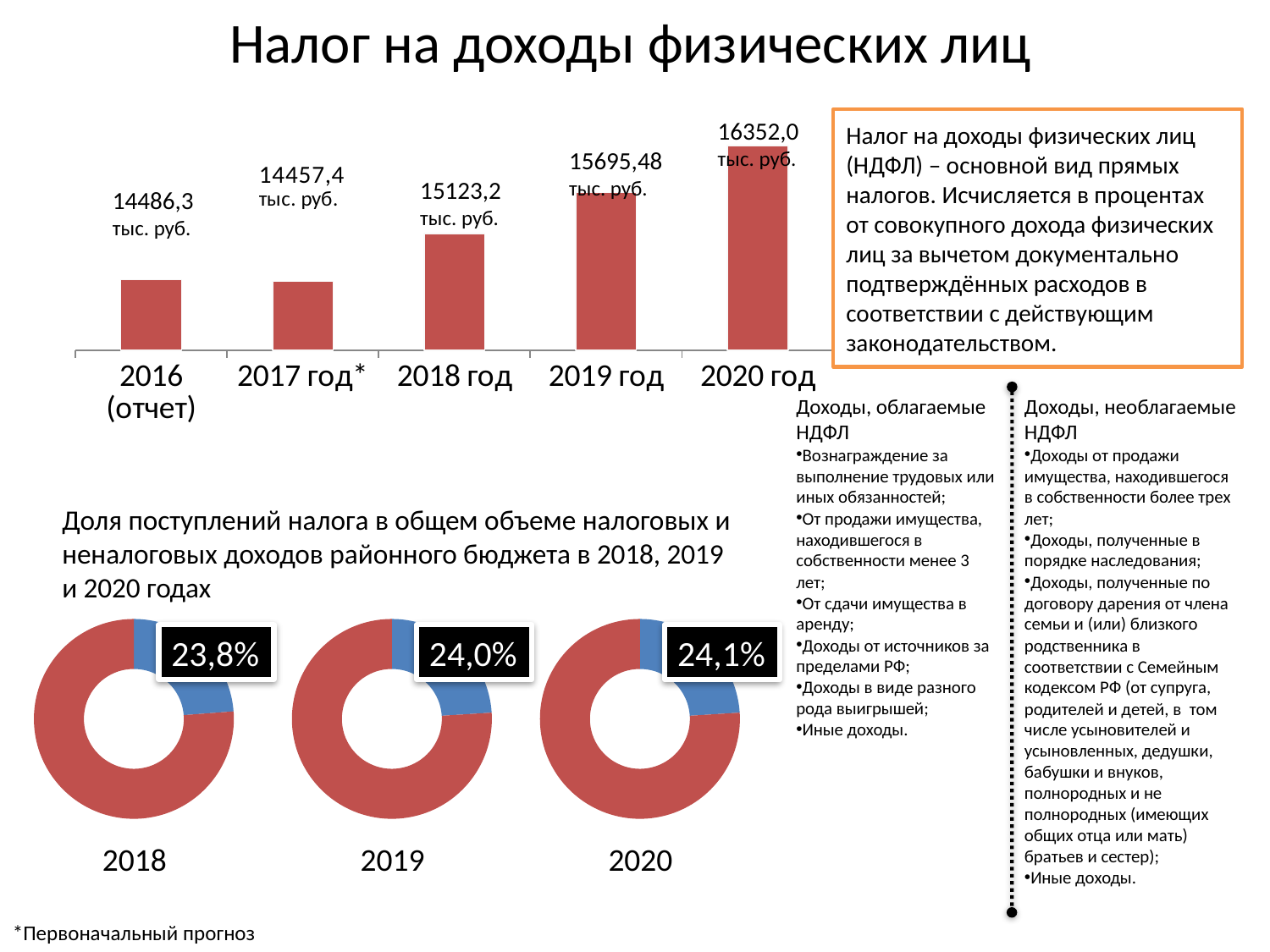
On the bar chart, which year has the highest value? 2020 год On the bar chart, what is the difference between the values for 2020 год and 2019 год? 656,52 тыс. руб. On the bar chart, what is the difference between the values for 2018 год and 2017 год*? 665,8 тыс. руб. How many bars are shown on the bar chart? 5 On the bar chart, what is the value for 2020 год? 16352,0 тыс. руб. On the bar chart, which year has the lowest value? 2017 год* On the bar chart, what is the value for 2016 (отчет)? 14486,3 тыс. руб. On the bar chart, which is larger: the value for 2019 год or the value for 2018 год? 2019 год On the bar chart, what is the value for 2018 год? 15123,2 тыс. руб. What kind of chart is the top chart on the slide? Bar chart On the donut chart for 2019, what share is shown by the data label? 24,0% Which donut chart shows a larger share: 2018 or 2020? 2020